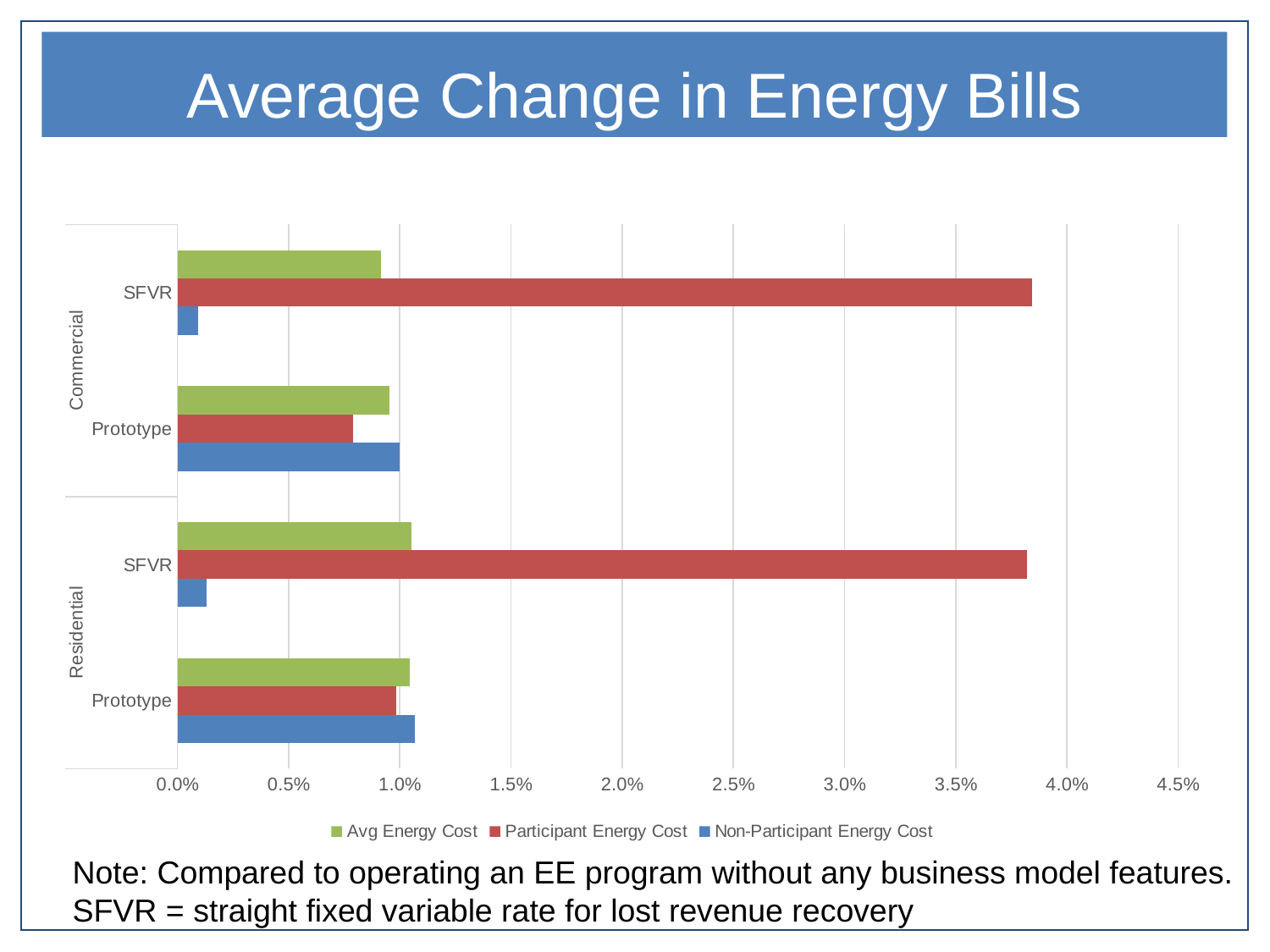
How many series does the legend list? 3 Is the Participant Energy Cost value for Commercial SFVR greater or less than 3.5%? greater Is the Participant Energy Cost value for Residential SFVR greater or less than 3.5%? greater How many category groups (bar clusters) are plotted on the chart? 4 Is the Non-Participant Energy Cost value for Residential SFVR greater or less than 0.5%? less For Commercial Prototype, which is larger: Avg Energy Cost or Participant Energy Cost? Avg Energy Cost For Residential SFVR, which series has the lowest value? Non-Participant Energy Cost What colour represents Participant Energy Cost in the legend? red What kind of chart is shown on the slide? bar chart For Commercial SFVR, which series has the highest value? Participant Energy Cost